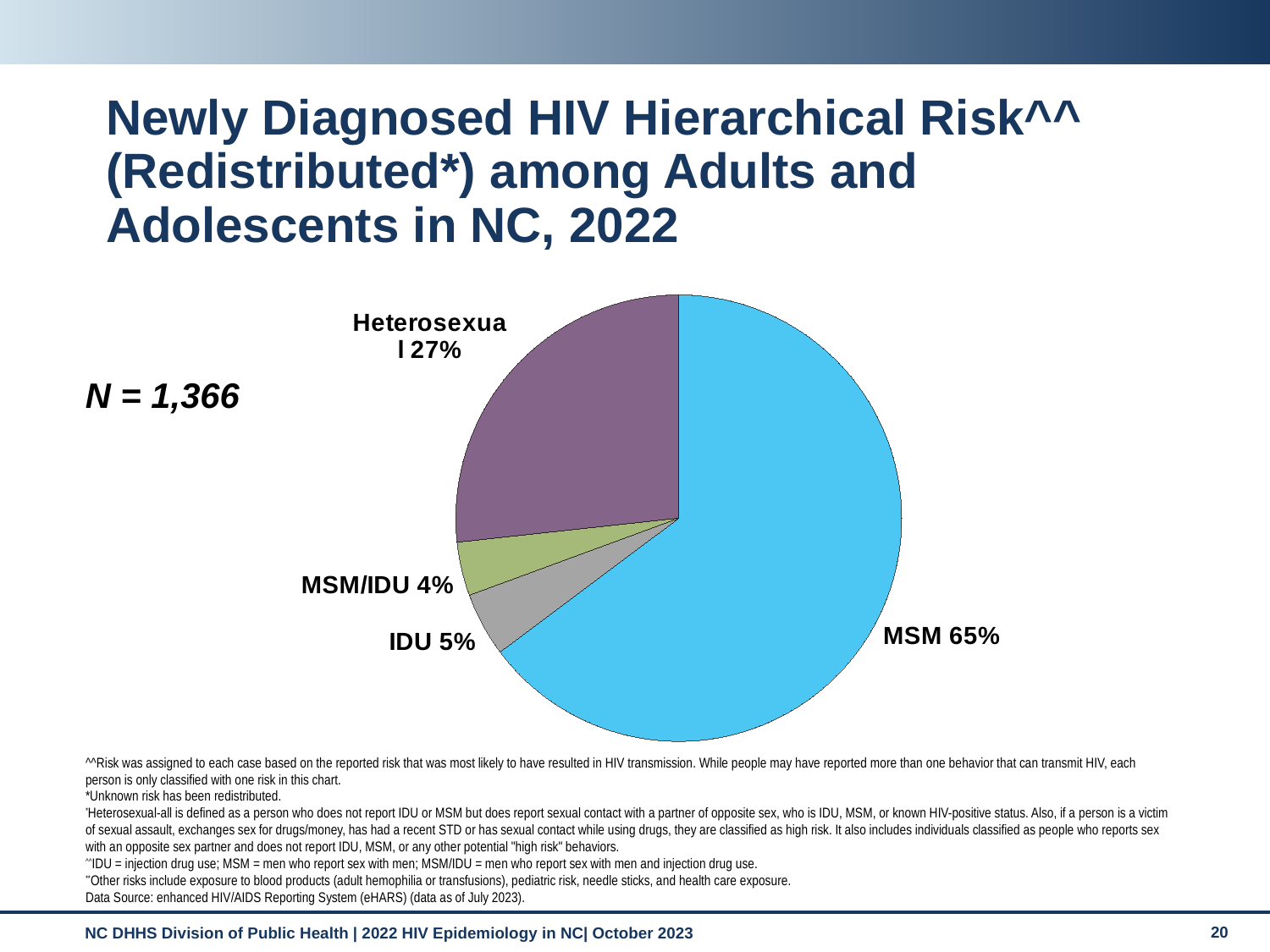
What kind of chart is shown on the slide? Pie chart Which risk category has the smallest slice of the pie? MSM/IDU How many slices does the pie chart have? 4 What percentage is shown for the Heterosexual slice? 27% What percentage is shown for MSM/IDU? 4% Which is larger, the IDU slice or the MSM/IDU slice? IDU What is the total N shown next to the chart? 1,366 Which risk category has the largest slice of the pie? MSM What colour is the MSM slice? Light blue What is the difference in percentage points between MSM and Heterosexual? 38 What percentage is shown for IDU? 5% What share of the pie does MSM account for? 65%